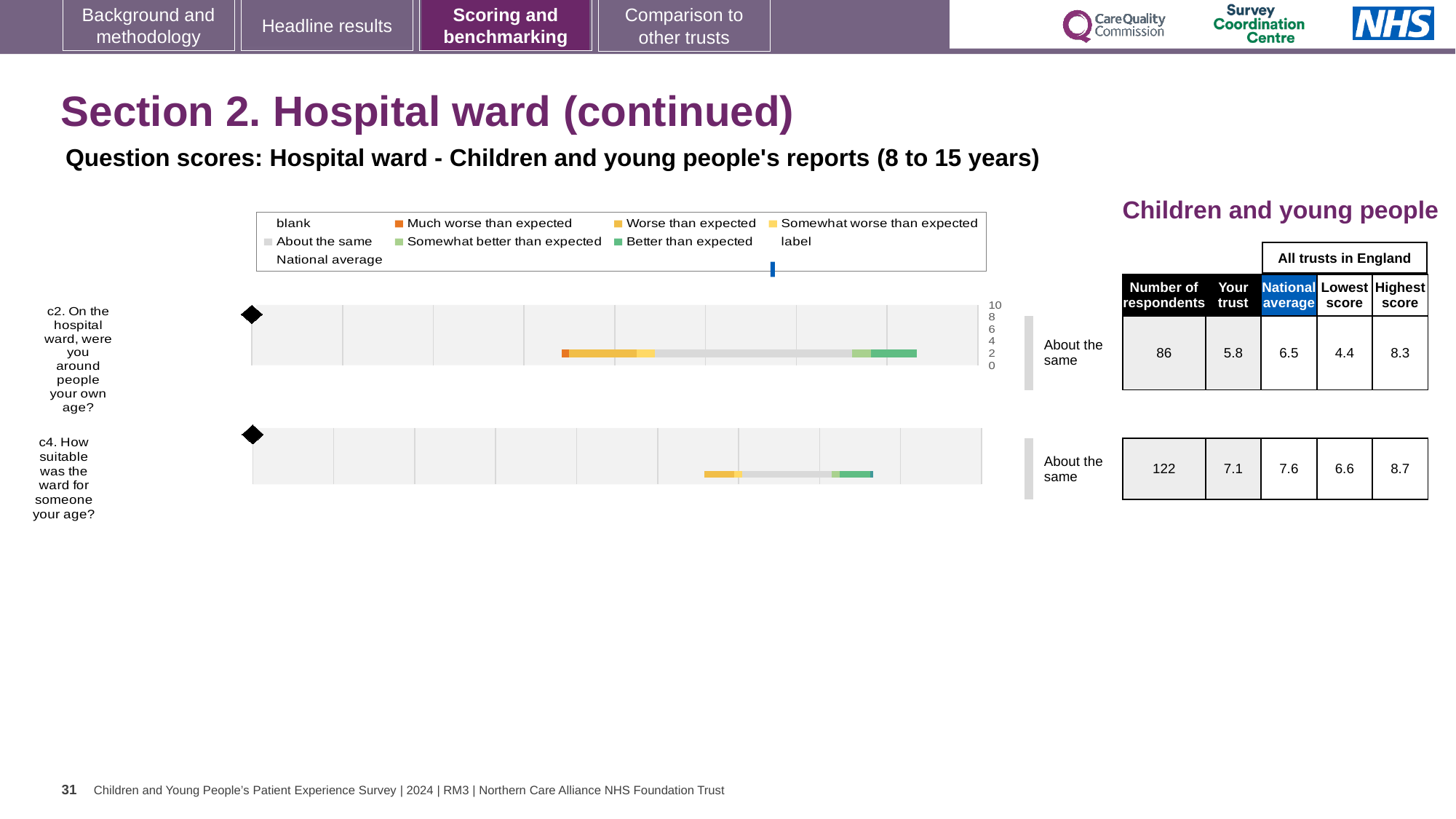
What kind of chart is used to show the question scores for c2 and c4? Bar chart What benchmark category is shown for question c2? About the same What is the lowest score among all trusts in England for question c2? 4.4 Which question has more respondents, c2 or c4? c4 By how much does the national average exceed the trust's score for question c2? 0.7 What is the difference between the highest and lowest scores for question c4? 2.1 How many respondents answered question c2? 86 How many questions (rows) are plotted in the chart? 2 Which question has the higher 'Your trust' score, c2 or c4? c4 What is the 'Your trust' score for question c2 (On the hospital ward, were you around people your own age?)? 5.8 What is the national average score for question c4 (How suitable was the ward for someone your age?)? 7.6 What is the highest score among all trusts in England for question c4? 8.7